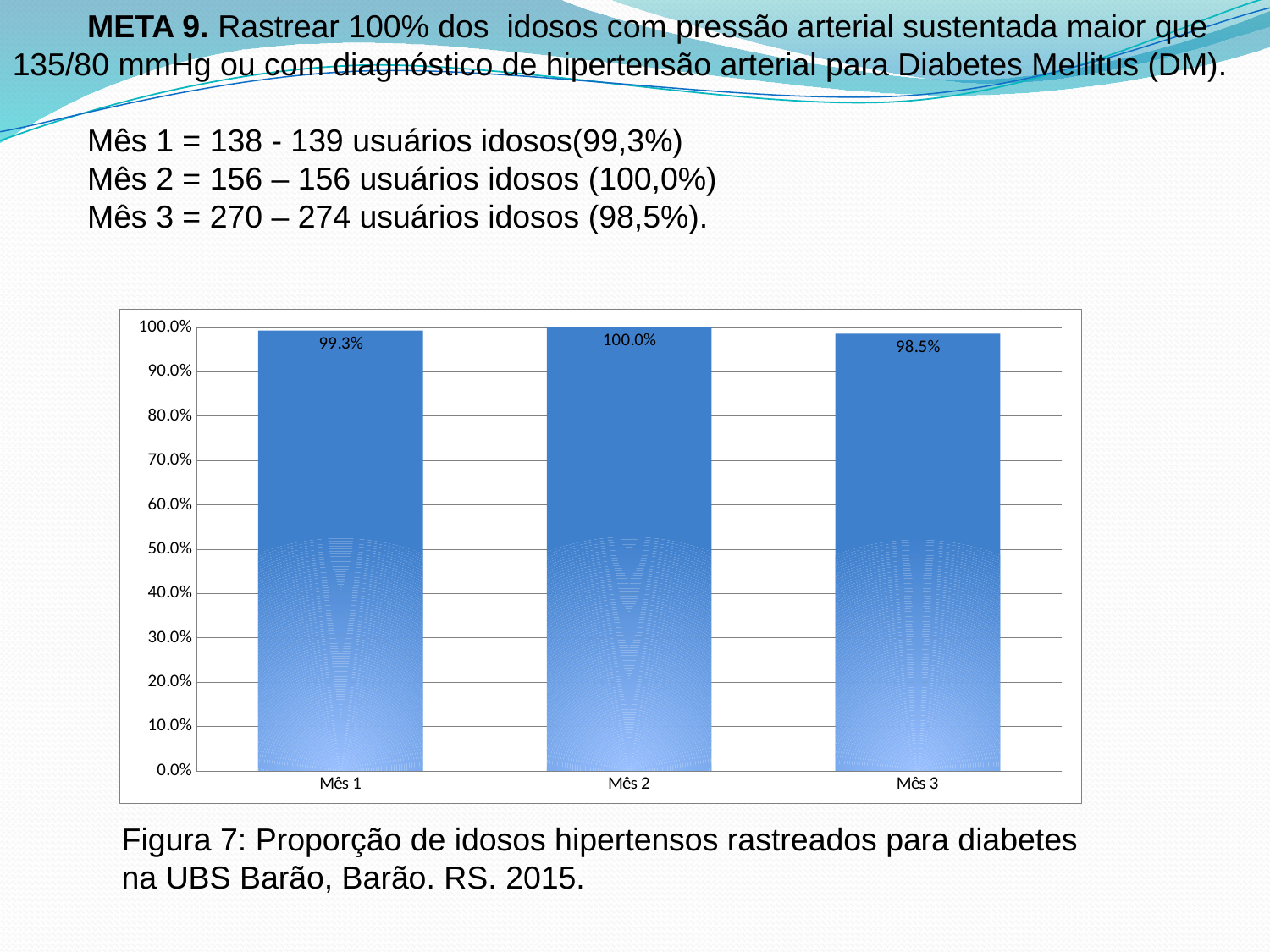
What is the value for Mês 1? 99.3% What is the value for Mês 2? 100.0% Is the value for Mês 3 greater or less than 90.0%? greater Which is larger, the value for Mês 1 or the value for Mês 3? Mês 1 Which month has the highest value? Mês 2 What is the caption of the figure below the chart? Figura 7: Proporção de idosos hipertensos rastreados para diabetes na UBS Barão, Barão. RS. 2015. Which month has the lowest value? Mês 3 What is the difference between the values for Mês 2 and Mês 3? 1.5% What is the difference between the values for Mês 1 and Mês 3? 0.8% What kind of chart is shown on the slide? bar chart What is the value for Mês 3? 98.5% How many categories are shown on the x axis? 3